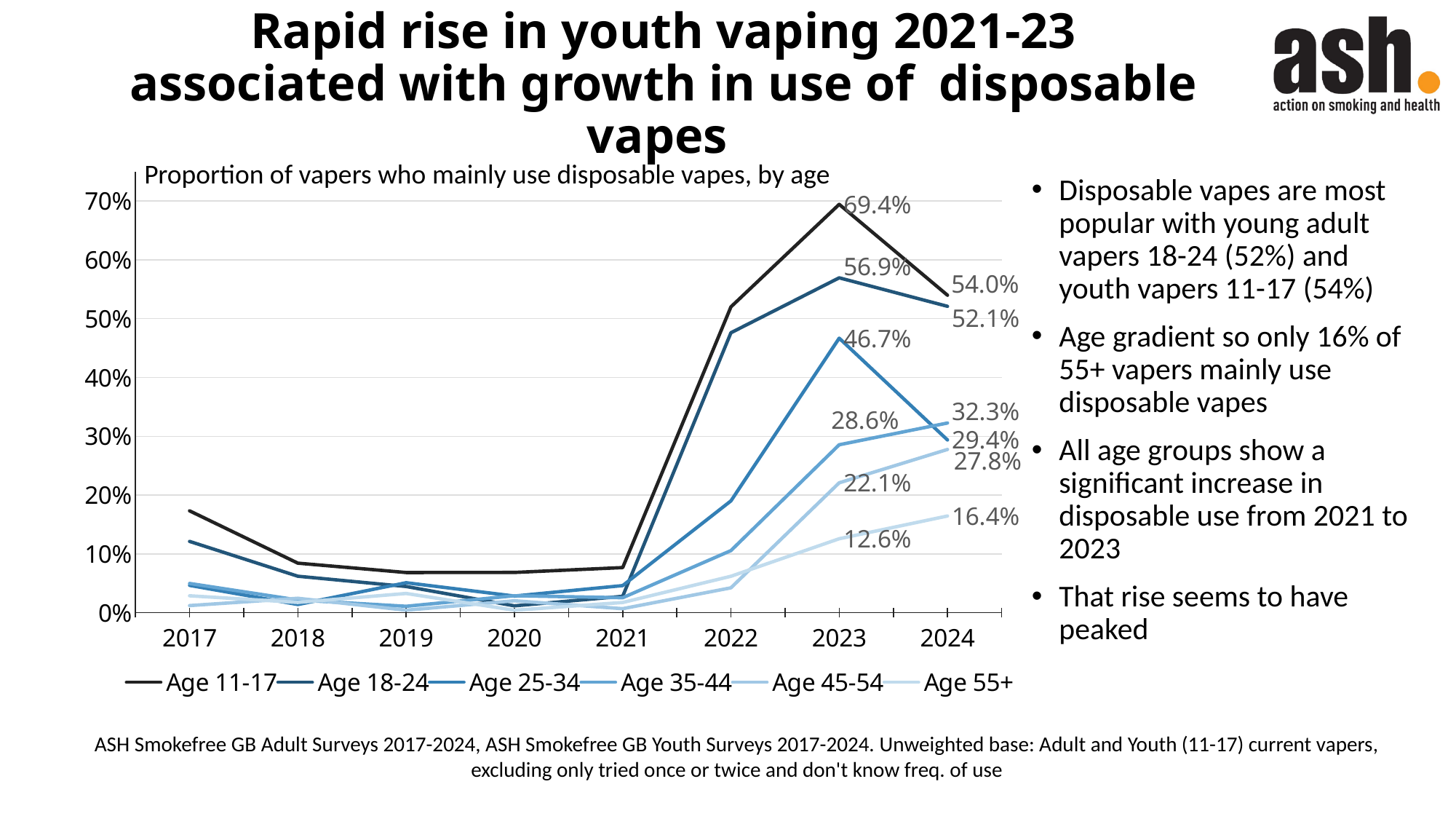
Did the Age 11-17 line rise or fall between 2021 and 2023? Rise How many age-group series does the legend list? 6 In 2023, which was larger: the value for Age 25-34 or Age 35-44? Age 25-34 What proportion of Age 11-17 vapers mainly used disposable vapes in 2023? 69.4% What is the value for Age 55+ in 2024? 16.4% Which age group had the highest proportion mainly using disposable vapes in 2023? Age 11-17 By how many percentage points did the Age 11-17 value fall from 2023 to 2024? 15.4 percentage points How many years are shown along the x axis? 8 What kind of chart is shown on the slide? Line chart Is the value for Age 11-17 in 2022 greater or less than 40%? greater What is the value for Age 18-24 in 2023? 56.9% Which age group had the lowest proportion mainly using disposable vapes in 2023? Age 55+